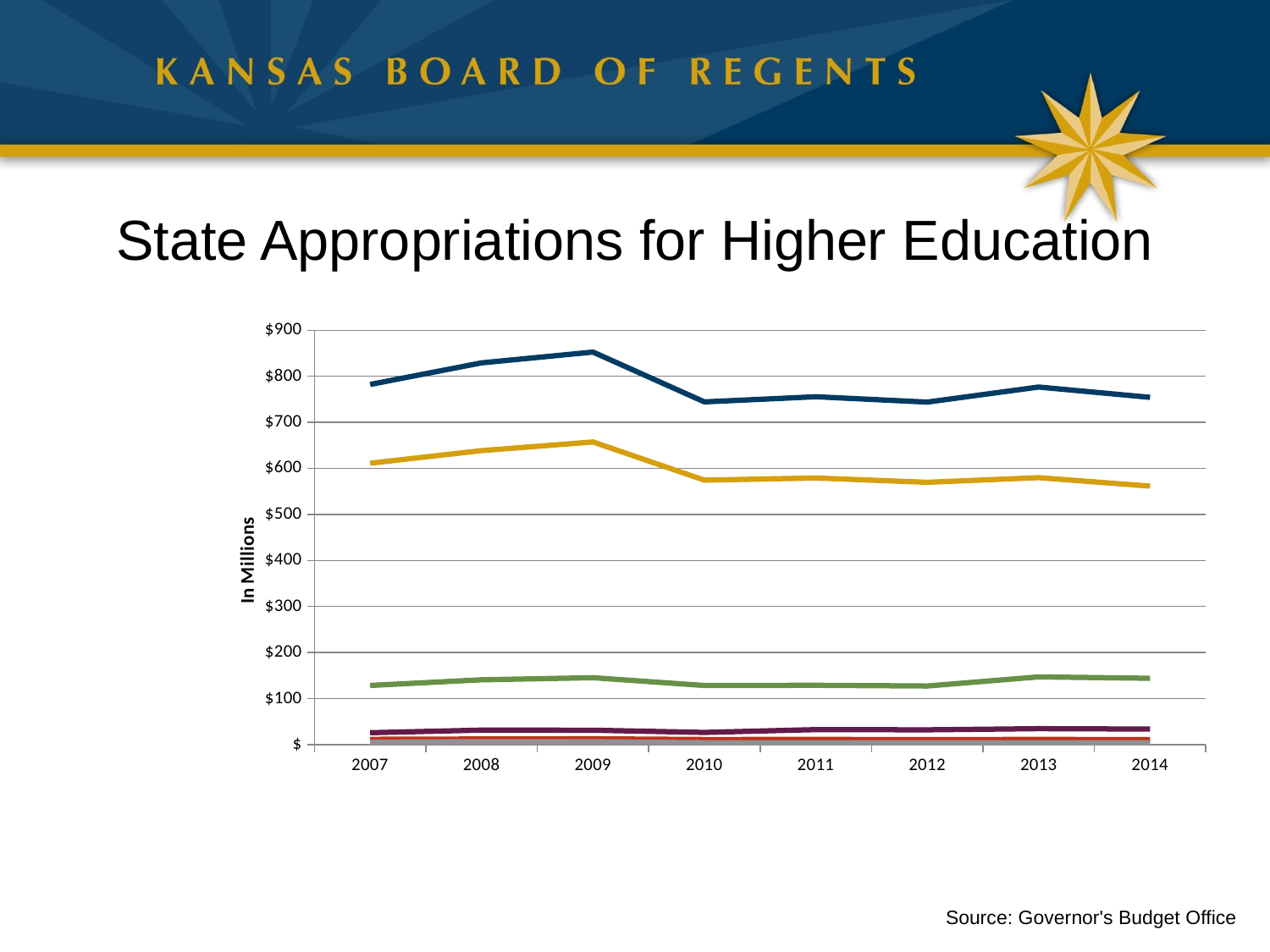
Is the value of the top (dark blue) line in 2010 greater or less than $800? less Is the value of the gold line in 2009 greater or less than $600? greater How many years are shown along the x axis of the chart? 8 What is the title of the chart on the slide? State Appropriations for Higher Education What kind of chart is shown on the slide? line chart In which year does the gold line reach its highest value? 2009 Is the value of the green line in 2013 greater or less than $100? greater What is the label on the vertical axis of the chart? In Millions Does the top (dark blue) line rise or fall from 2009 to 2010? fall In which year does the top (dark blue) line reach its highest value? 2009